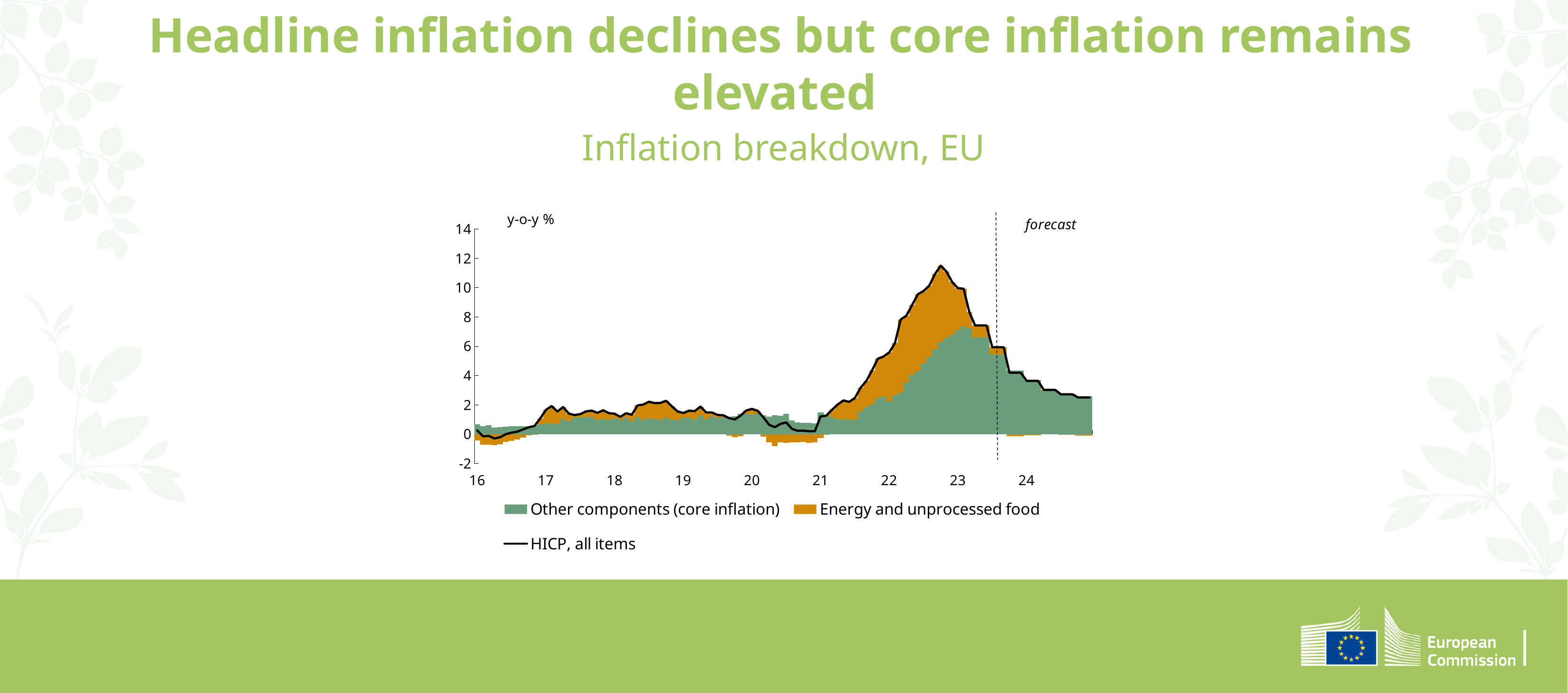
Is the value of the HICP, all items line at the start of 2016 greater or less than 2? less How many series does the legend list? 3 Is the Energy and unprocessed food contribution in mid-2020 greater or less than 0? less What unit is shown on the y axis of the chart? y-o-y % Is the peak value of the Other components (core inflation) bars greater or less than 6? greater What is the title of the chart? Inflation breakdown, EU Does the HICP, all items line rise or fall from its peak to the end of 2024? fall How many year labels are shown on the x axis? 9 In which year does the HICP, all items line reach its highest point? 2022 What kind of chart is shown on the slide? A stacked bar chart with a line overlay